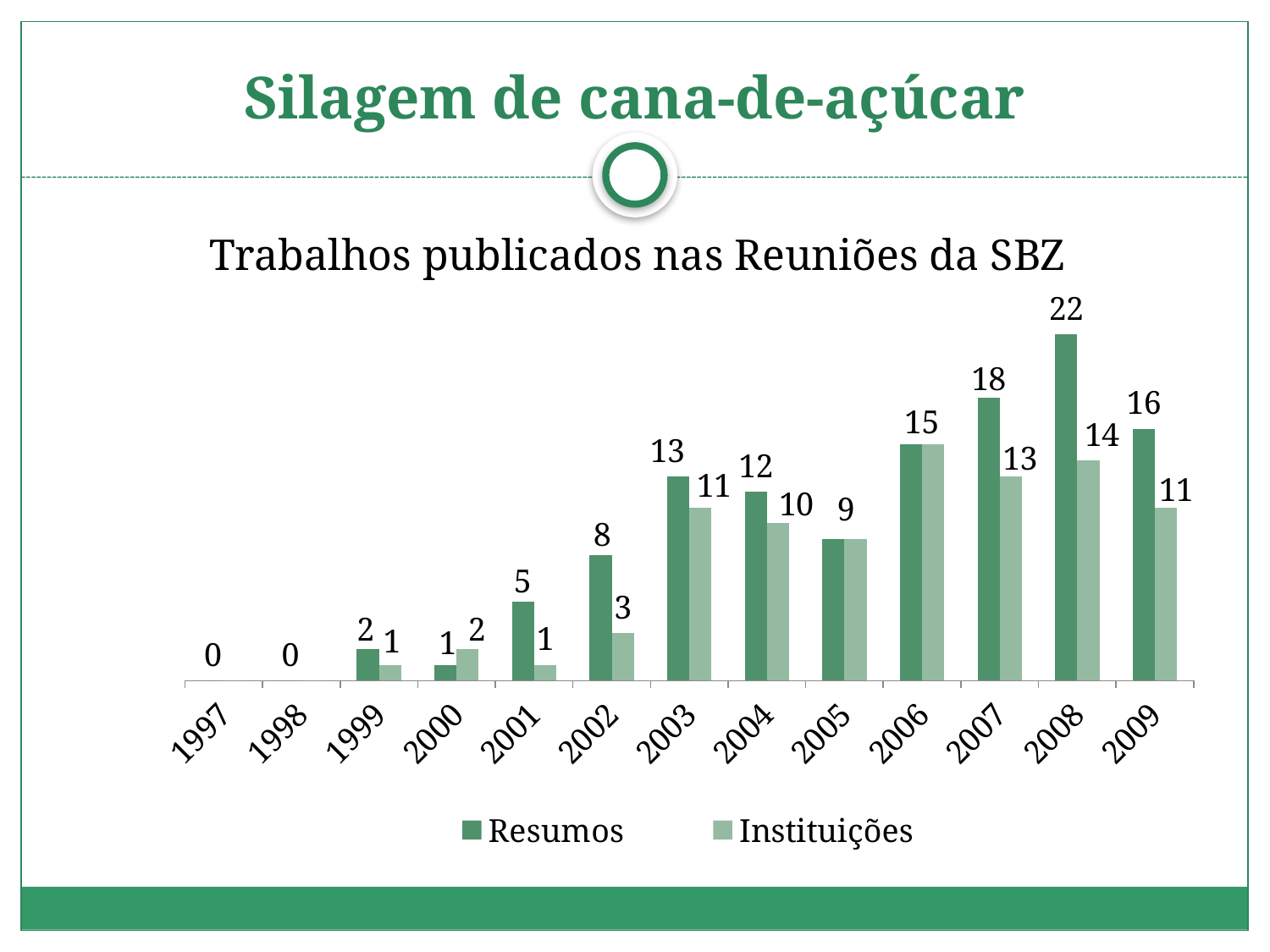
How many years are shown on the x axis? 13 Do the Resumos values rise or fall from 2006 to 2008? Rise What is the value of Resumos for 2001? 5 In which year is the Resumos value highest? 2008 What is the difference between Resumos and Instituições in 2008? 8 What kind of chart is shown? Bar chart How many series does the legend list? 2 What is the value of Instituições for 2003? 11 What is the value of Resumos for 2008? 22 In 2007, which is larger: Resumos or Instituições? Resumos What is the value of Instituições for 2002? 3 In 2000, which is larger: Resumos or Instituições? Instituições